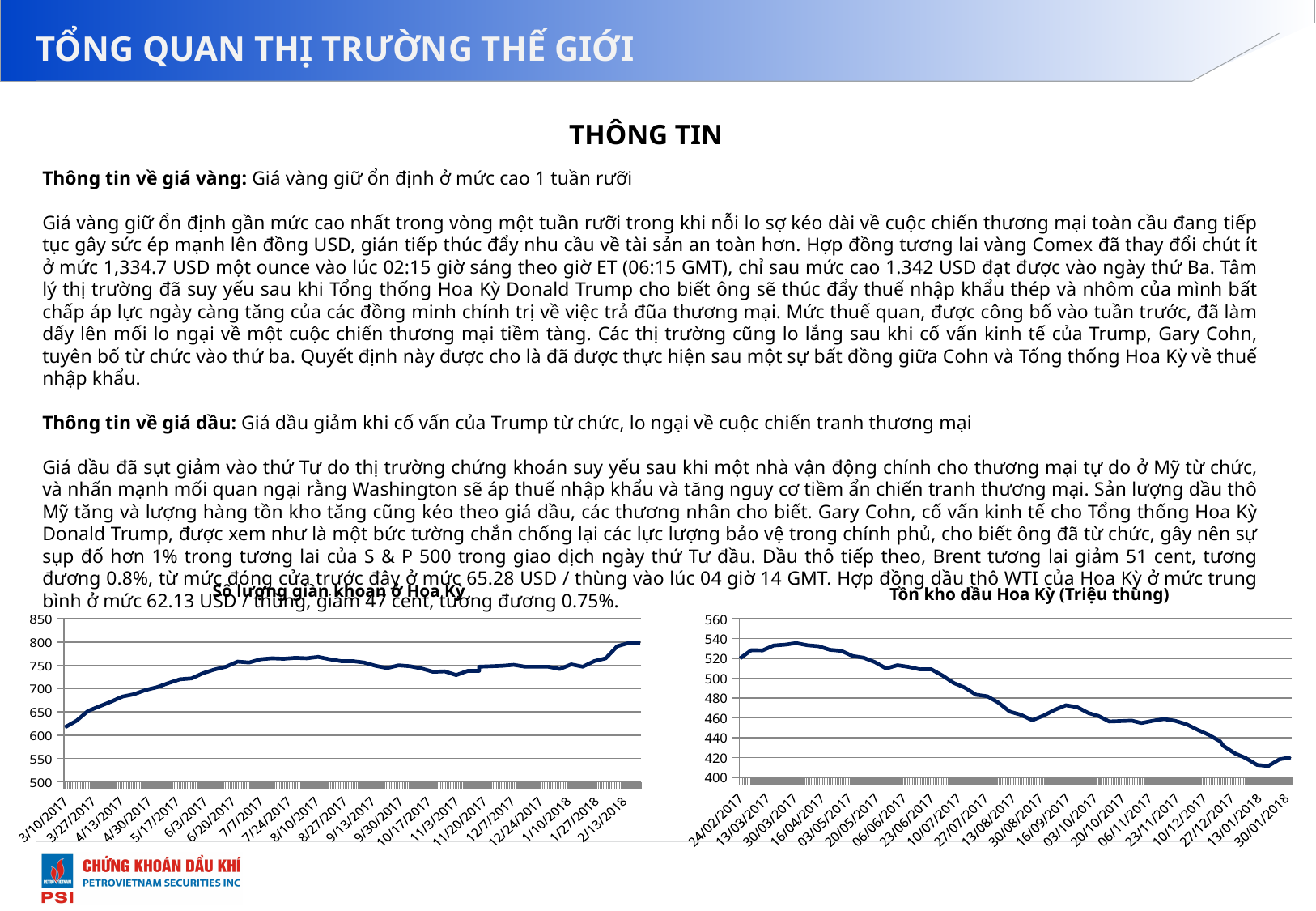
In the left chart 'Số lượng giàn khoan ở Hoa Kỳ', which date has the lowest value? 3/10/2017 In the right chart 'Tồn kho dầu Hoa Kỳ (Triệu thùng)', which is larger: the value for 24/02/2017 or the value for 30/01/2018? 24/02/2017 In the right chart 'Tồn kho dầu Hoa Kỳ (Triệu thùng)', do the values generally rise or fall from 24/02/2017 to 30/01/2018? Fall In the left chart 'Số lượng giàn khoan ở Hoa Kỳ', is the value for 3/10/2017 greater or less than 650? less In the right chart 'Tồn kho dầu Hoa Kỳ (Triệu thùng)', is the value for 24/02/2017 greater or less than 500? greater What unit is given in the title of the right chart? Triệu thùng What kind of chart is the left chart titled 'Số lượng giàn khoan ở Hoa Kỳ'? Line chart In the left chart 'Số lượng giàn khoan ở Hoa Kỳ', which is larger: the value for 3/10/2017 or the value for 2/13/2018? 2/13/2018 What kind of chart is the right chart titled 'Tồn kho dầu Hoa Kỳ (Triệu thùng)'? Line chart In the left chart 'Số lượng giàn khoan ở Hoa Kỳ', is the value for 2/13/2018 greater or less than 750? greater In the left chart 'Số lượng giàn khoan ở Hoa Kỳ', do the values generally rise or fall from 3/10/2017 to 2/13/2018? Rise